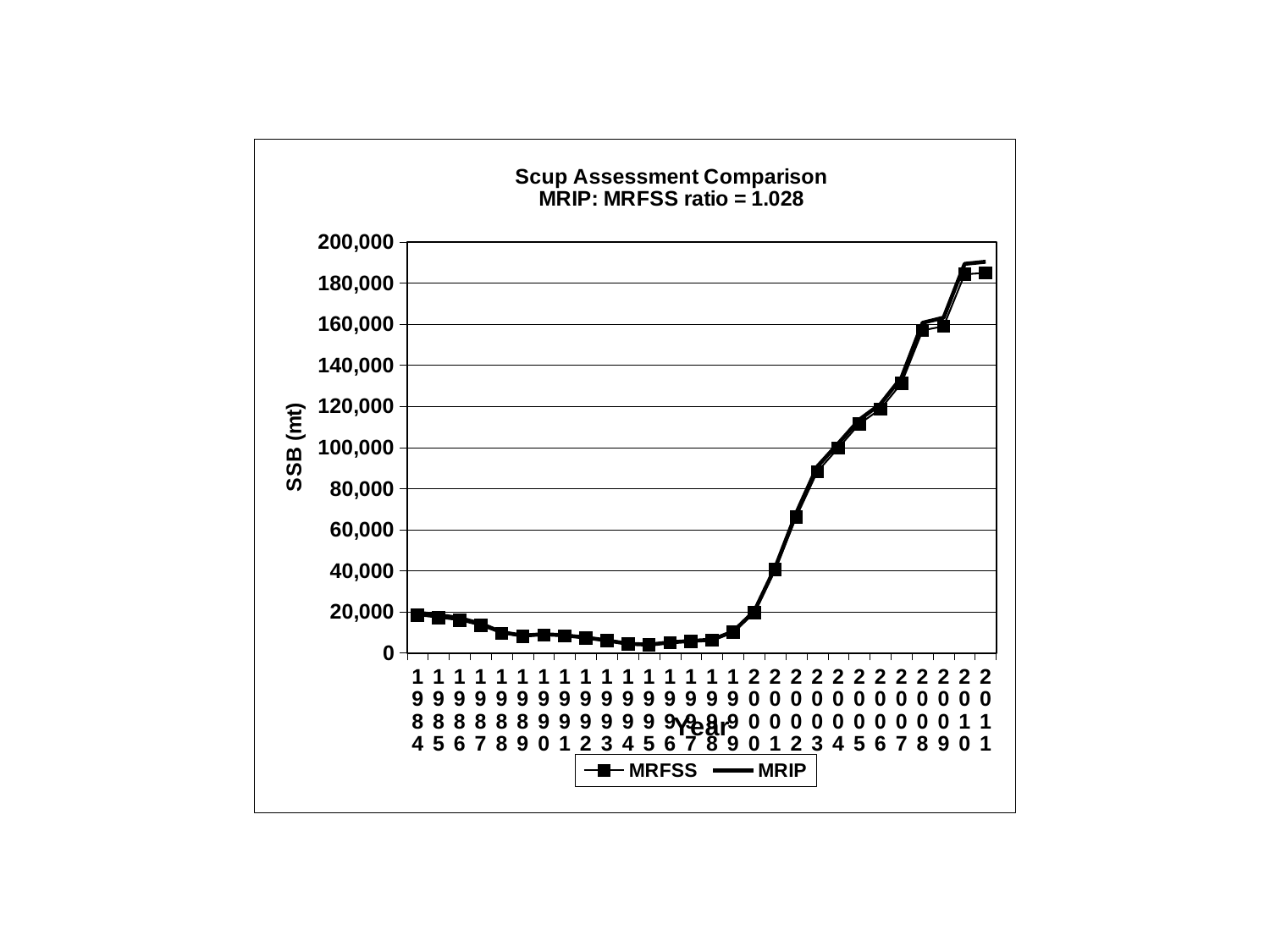
How many years are plotted along the x axis? 28 Is the MRFSS value for 2007 greater or less than 120,000? greater How many series does the legend list? 2 Do the SSB values generally rise or fall from 1999 to 2011? rise What kind of chart is shown on the slide? line chart What are the two series named in the legend? MRFSS and MRIP Is the MRFSS value for 1990 greater or less than 20,000? less Is the MRFSS value for 2002 greater or less than 60,000? greater Which is larger, the MRFSS value for 2002 or for 2001? 2002 What is the title of the chart? Scup Assessment Comparison MRIP: MRFSS ratio = 1.028